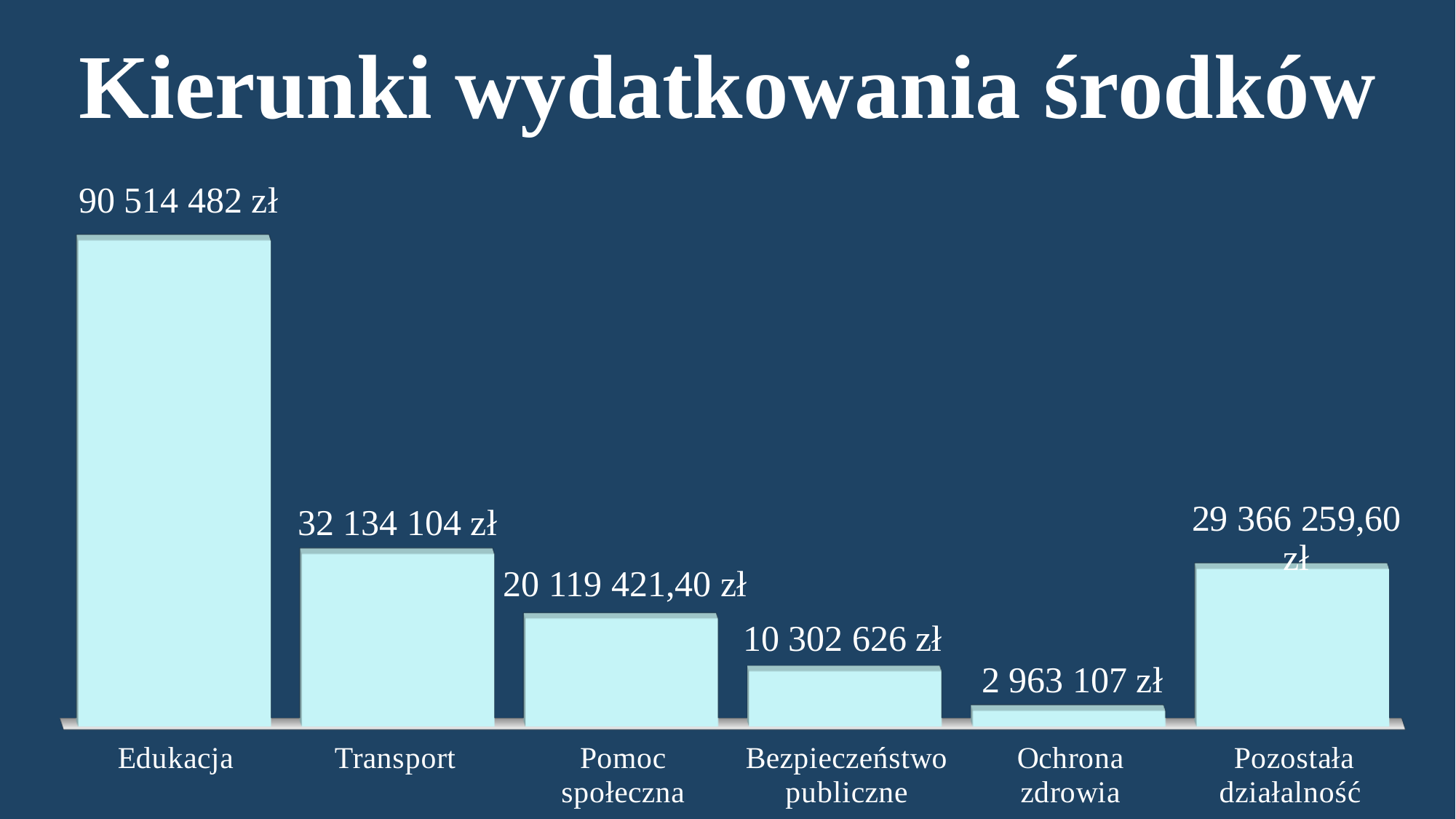
Which category has the lowest value? Ochrona zdrowia What is the value for Pozostała działalność? 29 366 259,60 zł What is the title of the chart? Kierunki wydatkowania środków What is the difference between the values for Bezpieczeństwo publiczne and Ochrona zdrowia? 7 339 519 zł What is the value for Pomoc społeczna? 20 119 421,40 zł How many categories are shown in the chart? 6 Which category has the highest value? Edukacja What is the value for Transport? 32 134 104 zł What is the value for Ochrona zdrowia? 2 963 107 zł Which is larger, the value for Transport or the value for Pozostała działalność? Transport What is the value for Edukacja? 90 514 482 zł What is the difference between the values for Edukacja and Transport? 58 380 378 zł